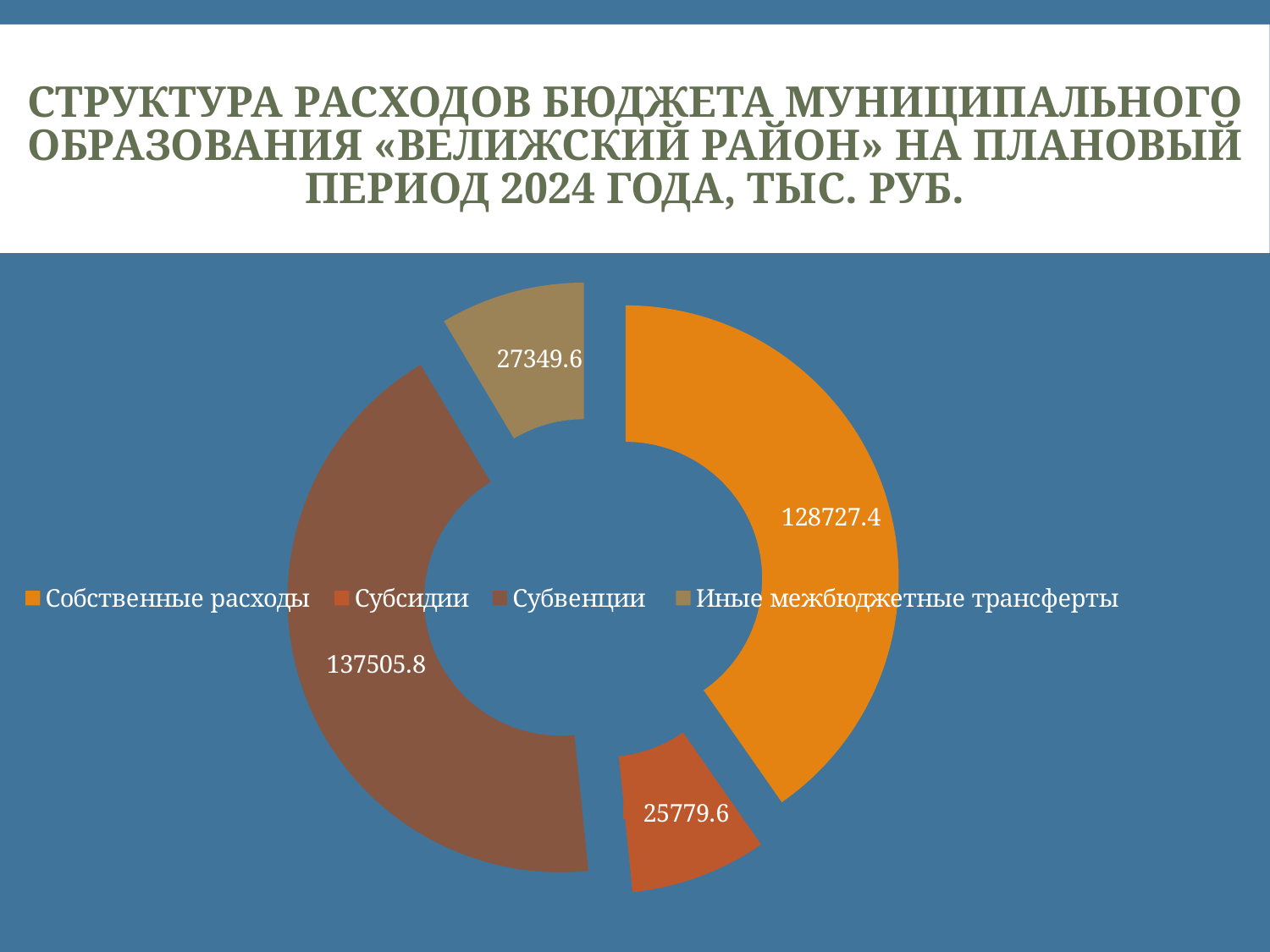
What is the value for Иные межбюджетные трансферты? 27349.6 What is the value for Собственные расходы? 128727.4 Which category has the smallest value? Субсидии What is the difference between Субвенции and Собственные расходы? 8778.4 What is the difference between Иные межбюджетные трансферты and Субсидии? 1570.0 How many categories does the chart show? 4 What is the total of all four categories shown in the chart? 319362.4 What is the value for Субсидии? 25779.6 What is the value for Субвенции? 137505.8 What kind of chart is shown on the slide? doughnut chart Which category has the largest value? Субвенции Which is larger, Собственные расходы or Субсидии? Собственные расходы